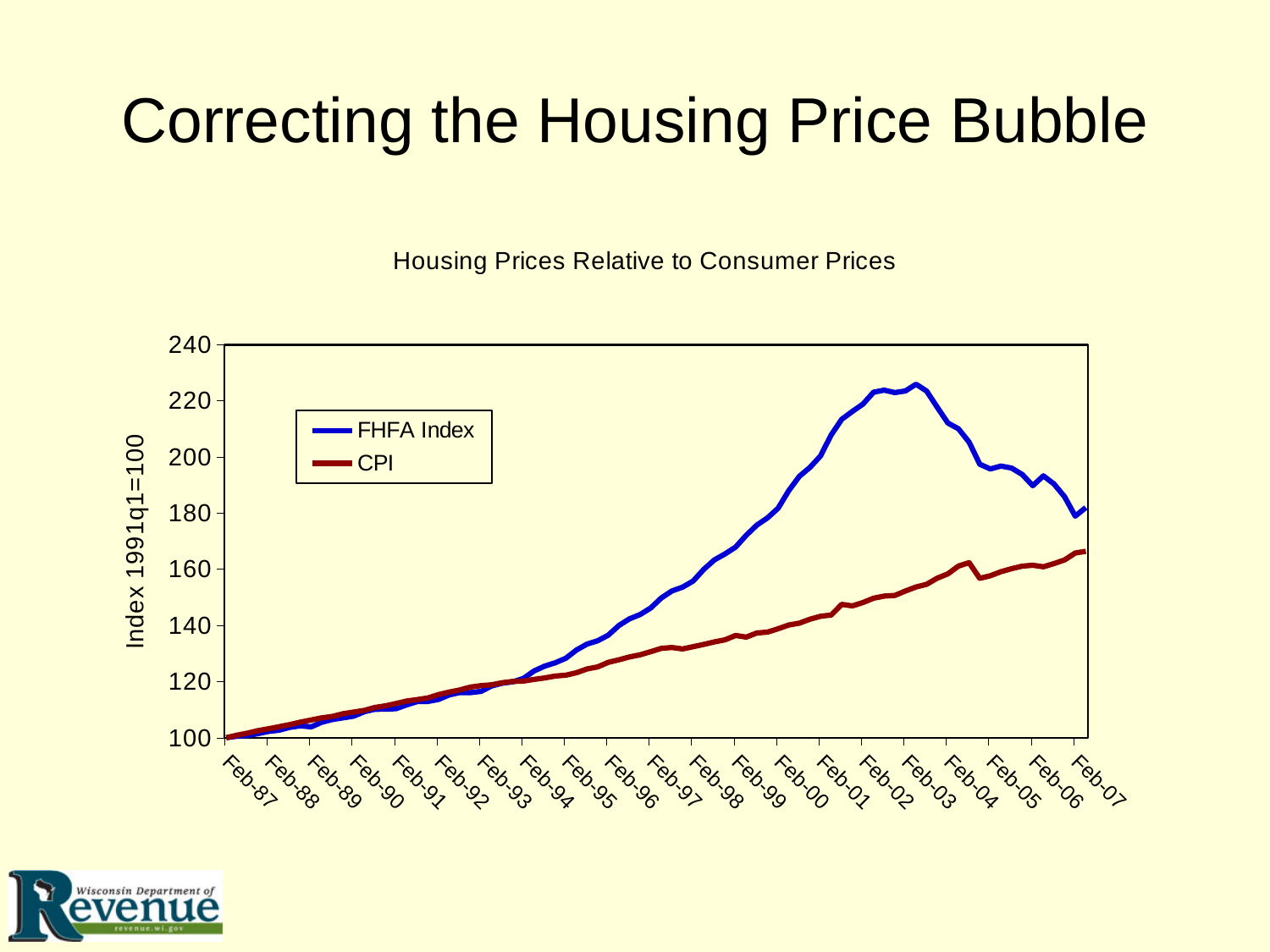
How many series does the legend list? 2 Does the FHFA Index rise or fall between Feb-03 and Feb-07? fall Is the value of the FHFA Index at Feb-03 greater or less than 220? greater Is the value of the CPI at Feb-07 greater or less than 160? greater At Feb-05, which series has the higher value, FHFA Index or CPI? FHFA Index Is the value of the CPI at Feb-97 greater or less than 140? less What is the title of the chart? Housing Prices Relative to Consumer Prices What are the two series named in the legend? FHFA Index and CPI Does the CPI series generally rise or fall from Feb-87 to Feb-07? rise How many date labels are shown along the x axis? 21 What kind of chart is shown on the slide? line chart